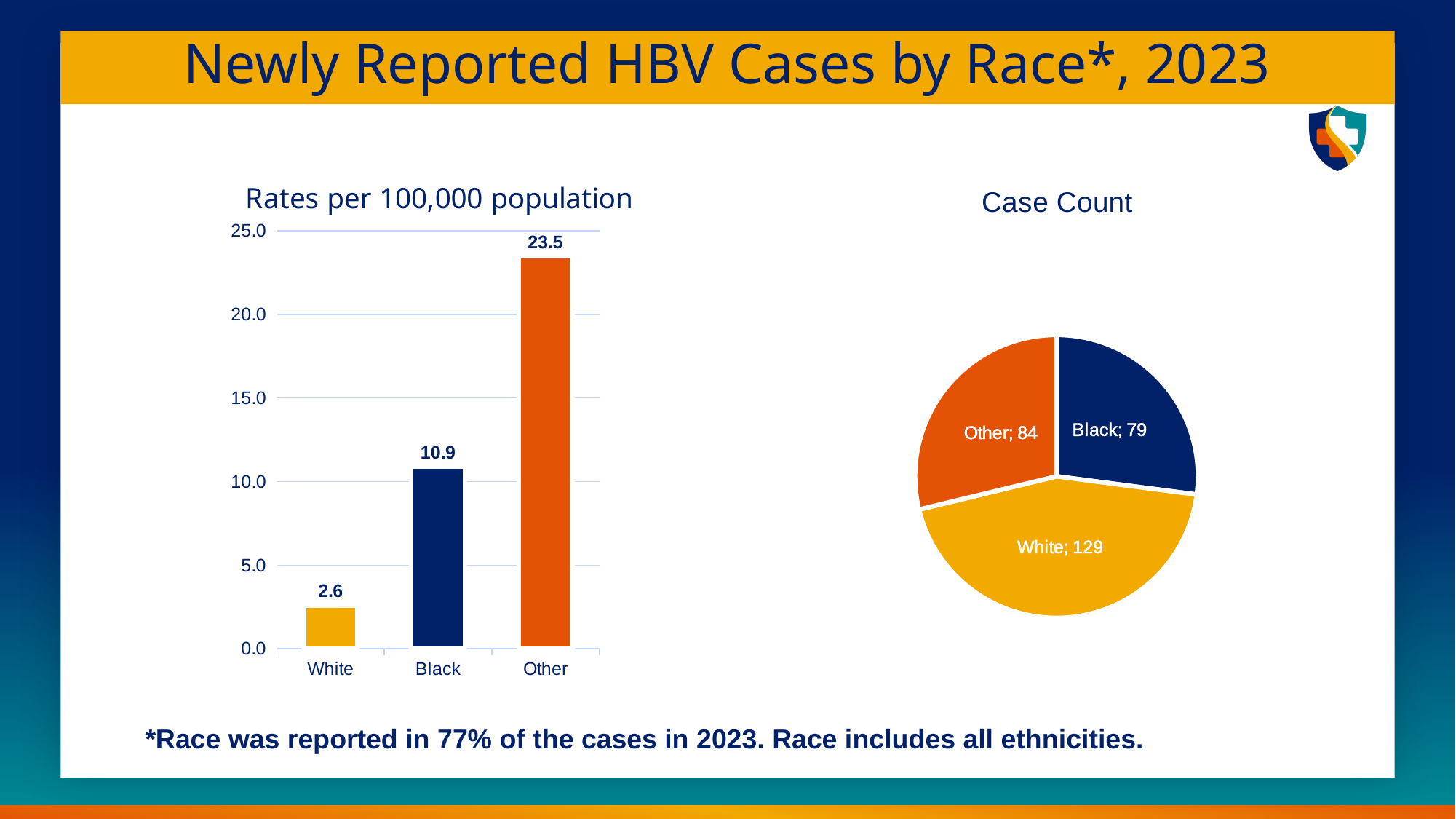
In the 'Rates per 100,000 population' chart, what is the rate for Black? 10.9 In the 'Rates per 100,000 population' chart, what is the rate for Other? 23.5 In the 'Rates per 100,000 population' chart, which category has the highest rate? Other In the 'Rates per 100,000 population' chart, is the rate for White greater or less than 5.0? less In the 'Case Count' pie chart, how many slices are there? 3 In the 'Rates per 100,000 population' chart, what is the difference between the rates for Other and Black? 12.6 In the 'Case Count' pie chart, what is the total number of cases across all three slices? 292 What kind of chart is the 'Rates per 100,000 population' chart? bar chart In the 'Case Count' pie chart, how many cases are reported for White? 129 In the 'Case Count' pie chart, which category has the largest slice? White In the 'Case Count' pie chart, how many cases are reported for Black? 79 In the 'Rates per 100,000 population' chart, which category has the lowest rate? White